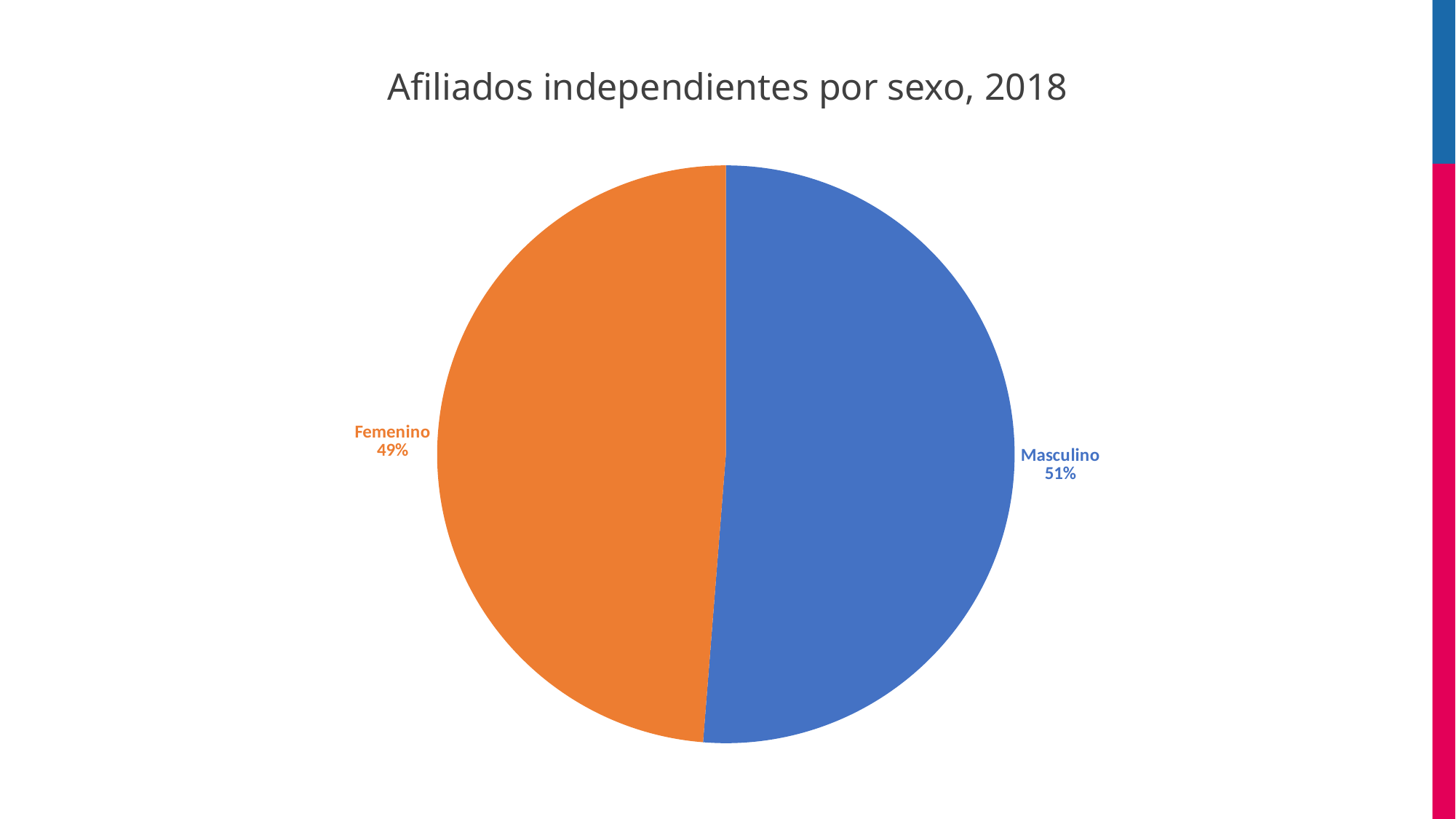
How many slices does the pie chart have? 2 What is the title of the chart? Afiliados independientes por sexo, 2018 Is the share for Masculino greater or less than 50%? greater What kind of chart is shown on the slide? pie chart What share of the pie does Femenino represent? 49% Which category has the smallest slice? Femenino What is the difference in percentage points between Masculino and Femenino? 2 percentage points What share of the pie does Masculino represent? 51% Which category has the largest slice? Masculino Which colour is used for the Femenino slice? orange